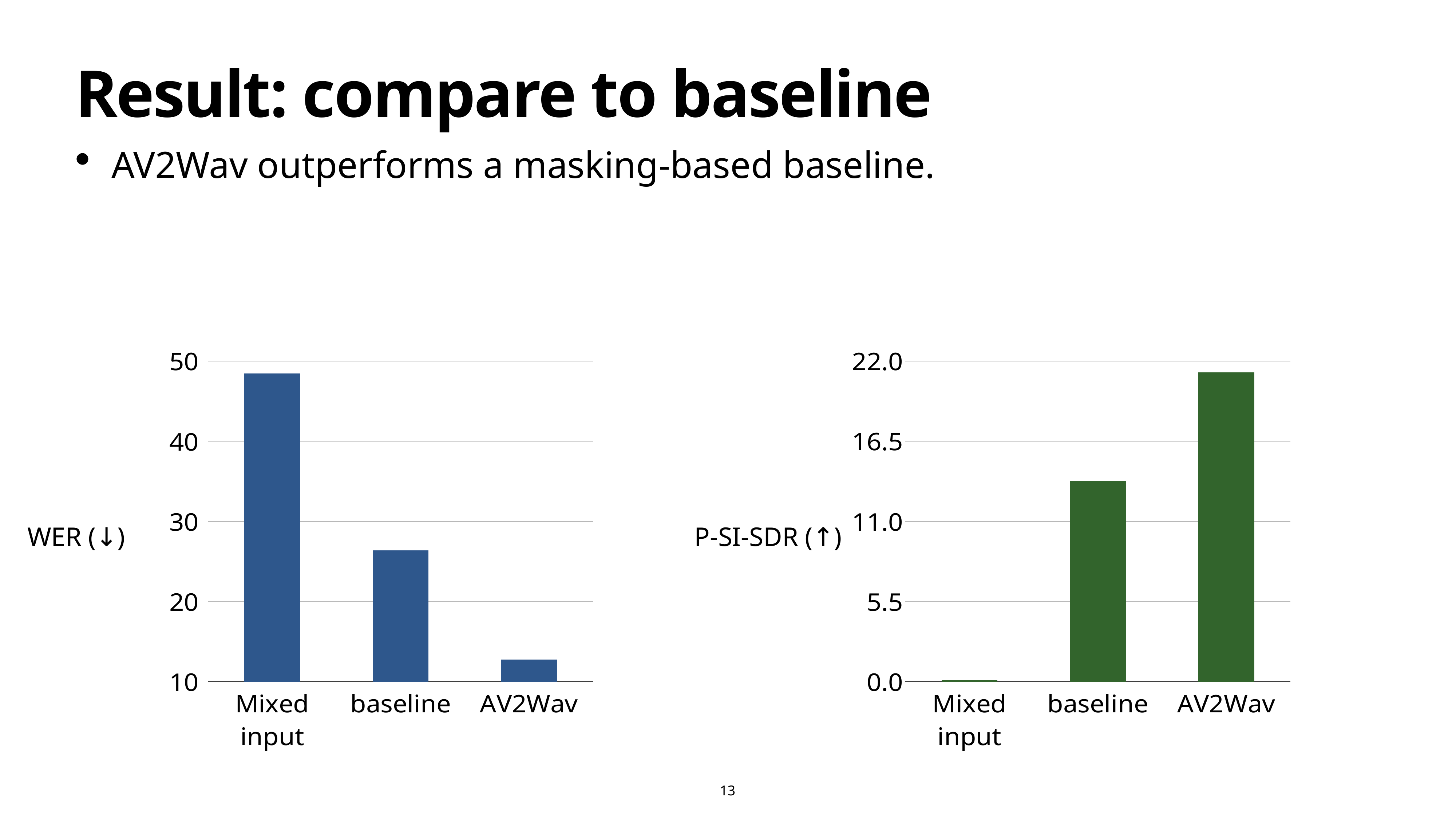
In the WER (↓) chart on the left, do the values rise or fall from Mixed input to AV2Wav? fall In the P-SI-SDR (↑) chart on the right, is the value for baseline greater or less than 11.0? greater In the WER (↓) chart on the left, which category has the highest value? Mixed input What colour are the bars in the P-SI-SDR (↑) chart on the right? green In the WER (↓) chart on the left, which category has the lowest value? AV2Wav In the P-SI-SDR (↑) chart on the right, which category has the highest value? AV2Wav How many categories does the WER (↓) chart on the left show? 3 In the WER (↓) chart on the left, is the value for Mixed input greater or less than 40? greater What kind of chart is the WER (↓) chart on the left? bar chart In the P-SI-SDR (↑) chart on the right, which category has the lowest value? Mixed input In the P-SI-SDR (↑) chart on the right, which is larger, the value for baseline or the value for AV2Wav? AV2Wav In the WER (↓) chart on the left, is the value for baseline greater or less than 30? less